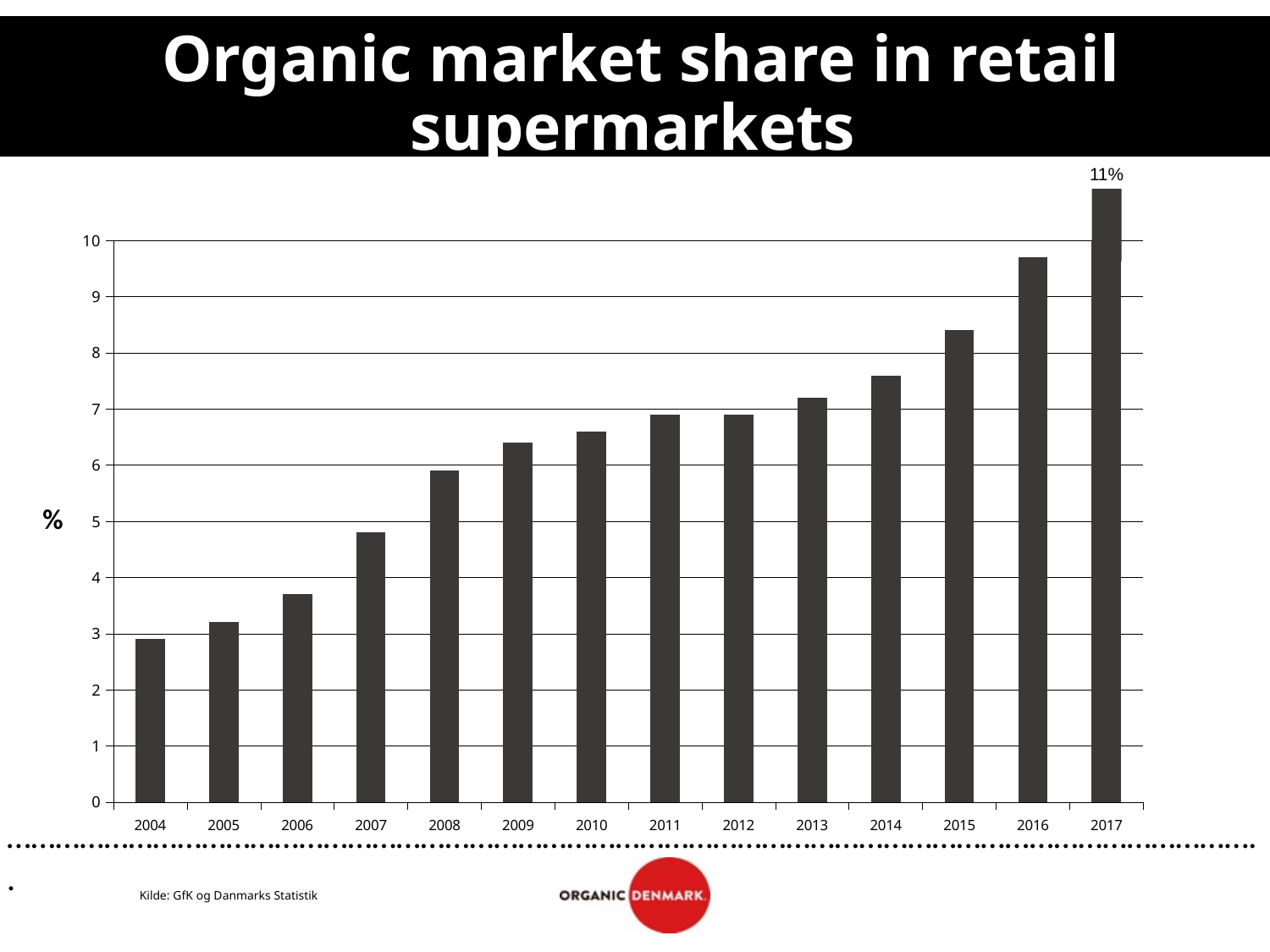
How many years are shown on the x axis? 14 Is the value for 2010 greater or less than 7? less Is the value for 2004 greater or less than 4? less Which year has the lowest organic market share? 2004 What is the value shown for 2017? 11% Is the value for 2015 greater or less than 8? greater What is the title of the chart? Organic market share in retail supermarkets Which year has the highest organic market share? 2017 Do the values rise or fall from 2004 to 2017? Rise What kind of chart is shown on the slide? Bar chart Which is larger, the value for 2015 or the value for 2016? 2016